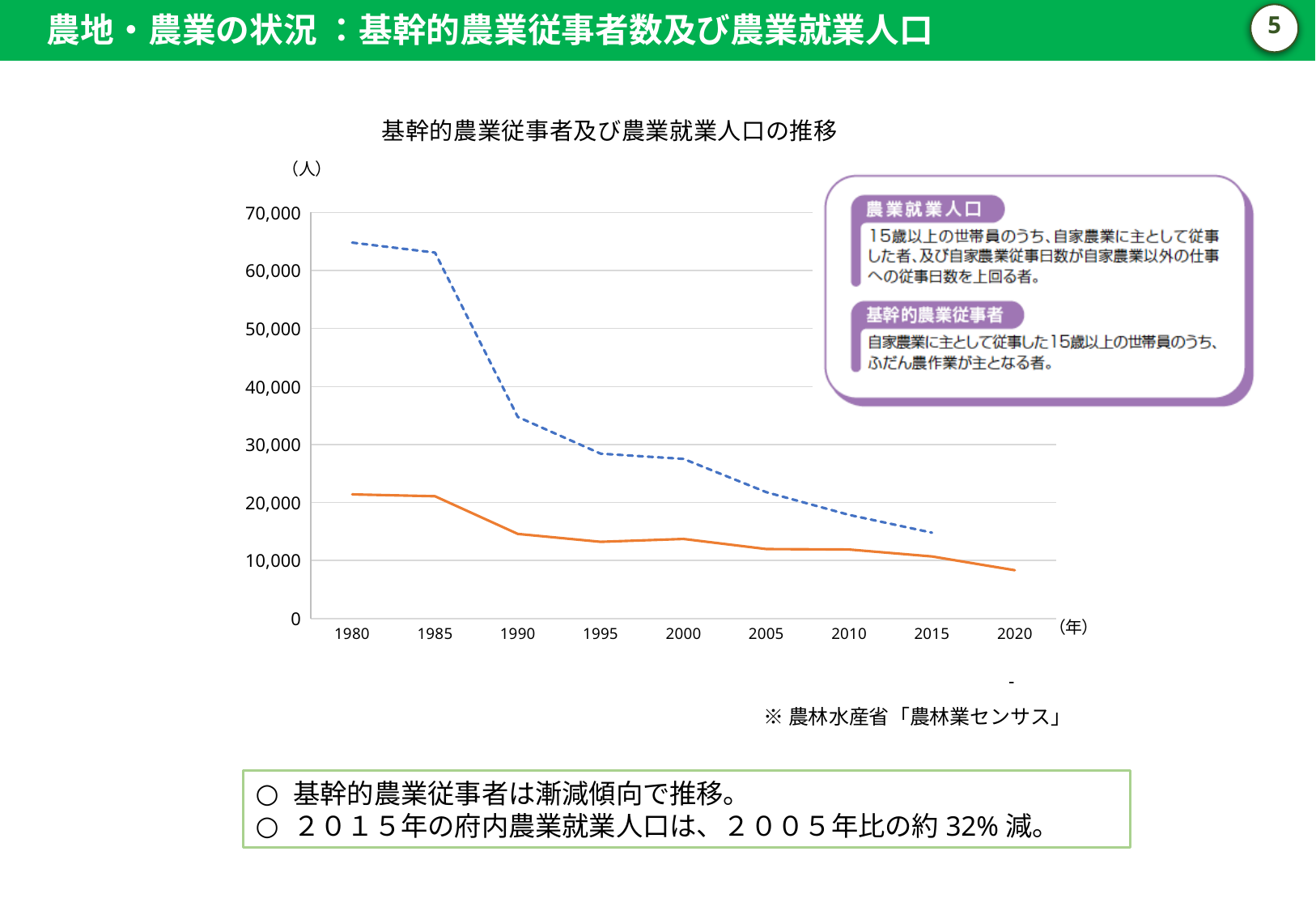
In 2000, which line has the larger value, the dashed blue line or the solid orange line? the dashed blue line Is the value of the dashed blue line in 1990 greater or less than 30,000? greater How many years are marked on the x axis of the chart? 9 Is the value of the dashed blue line in 1980 greater or less than 60,000? greater In which year does the dashed blue line reach its highest value? 1980 Is the value of the solid orange line in 2020 greater or less than 10,000? less In which year does the solid orange line reach its lowest value? 2020 What kind of chart is shown on the slide? line chart How many lines are plotted on the chart? 2 What is the title of the chart? 基幹的農業従事者及び農業就業人口の推移 Do the values of the solid orange line rise or fall from 1980 to 2020? fall